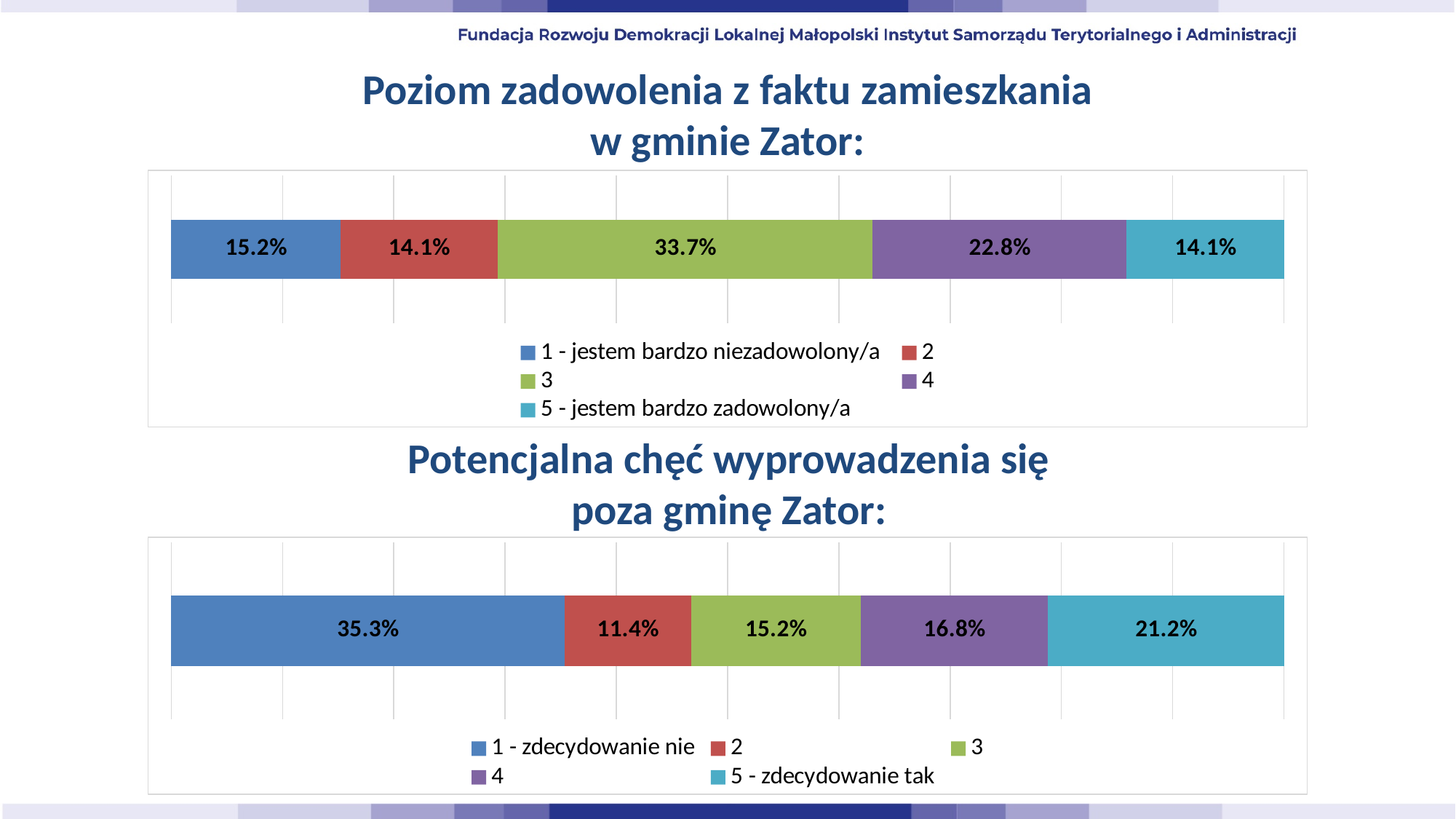
In the bottom chart (Potencjalna chęć wyprowadzenia się poza gminę Zator), which is larger: the value for series 4 or the value for series 3? 4 In the bottom chart (Potencjalna chęć wyprowadzenia się poza gminę Zator), what is the value for '1 - zdecydowanie nie'? 35.3% In the top chart (Poziom zadowolenia z faktu zamieszkania w gminie Zator), how many series does the legend list? 5 In the top chart (Poziom zadowolenia z faktu zamieszkania w gminie Zator), what is the value for '5 - jestem bardzo zadowolony/a'? 14.1% What kind of chart is the bottom chart (Potencjalna chęć wyprowadzenia się poza gminę Zator)? Stacked bar chart In the bottom chart (Potencjalna chęć wyprowadzenia się poza gminę Zator), which series has the lowest value? 2 In the top chart (Poziom zadowolenia z faktu zamieszkania w gminie Zator), what is the value for series 3? 33.7% In the bottom chart (Potencjalna chęć wyprowadzenia się poza gminę Zator), what is the value for '5 - zdecydowanie tak'? 21.2% In the bottom chart (Potencjalna chęć wyprowadzenia się poza gminę Zator), what is the difference between the values for '1 - zdecydowanie nie' and '5 - zdecydowanie tak'? 14.1% In the top chart (Poziom zadowolenia z faktu zamieszkania w gminie Zator), what colour is the segment for series 3? Green In the top chart (Poziom zadowolenia z faktu zamieszkania w gminie Zator), which series has the highest value? 3 In the top chart (Poziom zadowolenia z faktu zamieszkania w gminie Zator), what is the difference between the values for series 3 and series 4? 10.9%